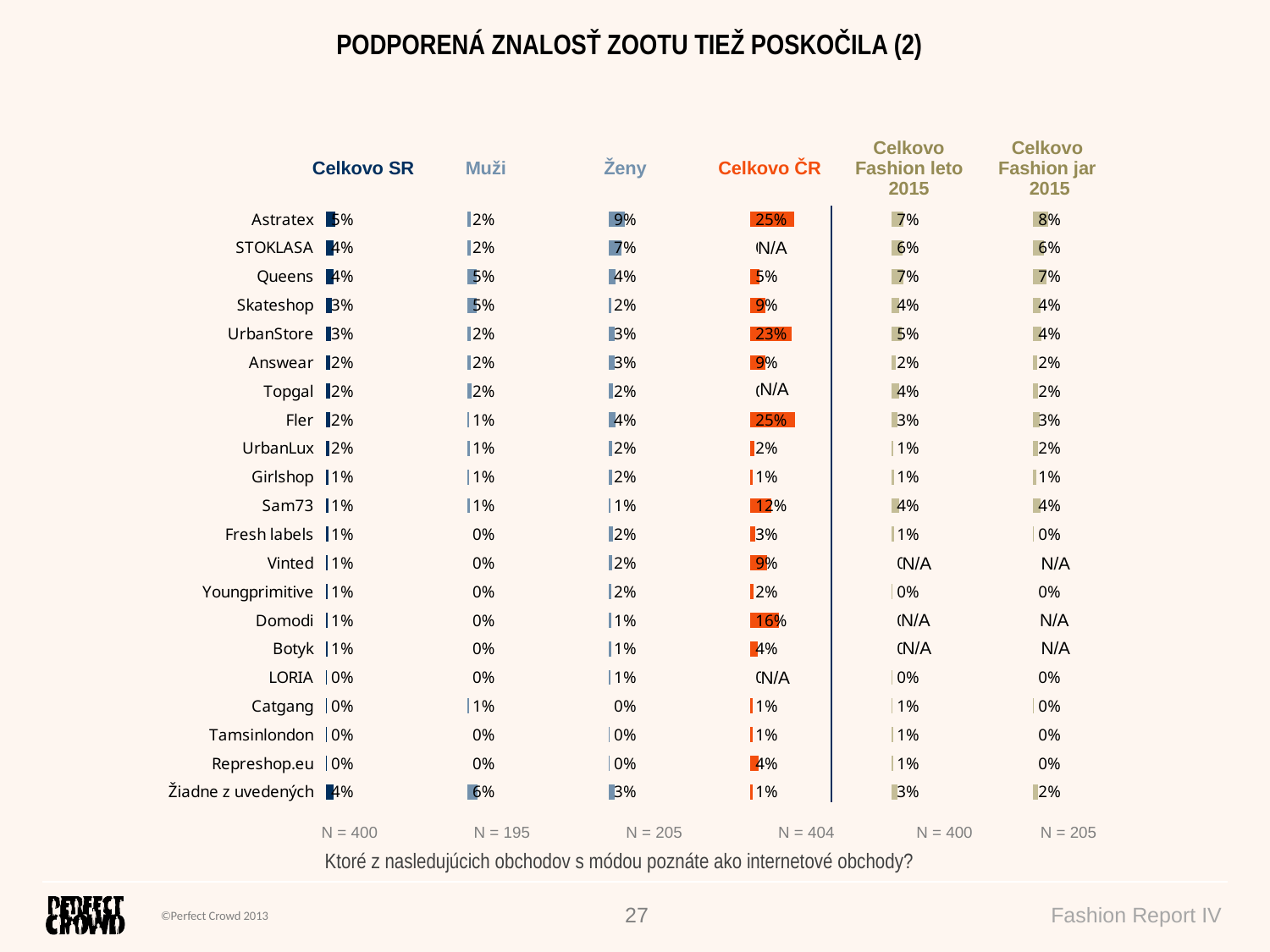
How many categories (rows) are listed in each chart? 21 In the Celkovo SR chart, what is the value for Astratex? 5% In the Celkovo SR chart, which brand has the highest value? Astratex In the Celkovo ČR chart, what is shown for Domodi? 16% In the Celkovo ČR chart, which is larger: Skateshop or Fler? Fler In the Celkovo Fashion leto 2015 chart, what is the value for Sam73? 4% In the Celkovo ČR chart, what is the value for UrbanStore? 23% In the Muži chart, which category has the highest value? Žiadne z uvedených In the Celkovo ČR chart, what is the difference between Astratex and Sam73? 13% In the Ženy chart, what is the value for STOKLASA? 7% What is the sample size (N) shown for the Celkovo ČR chart? N = 404 In the Ženy chart, which brand has the highest value? Astratex